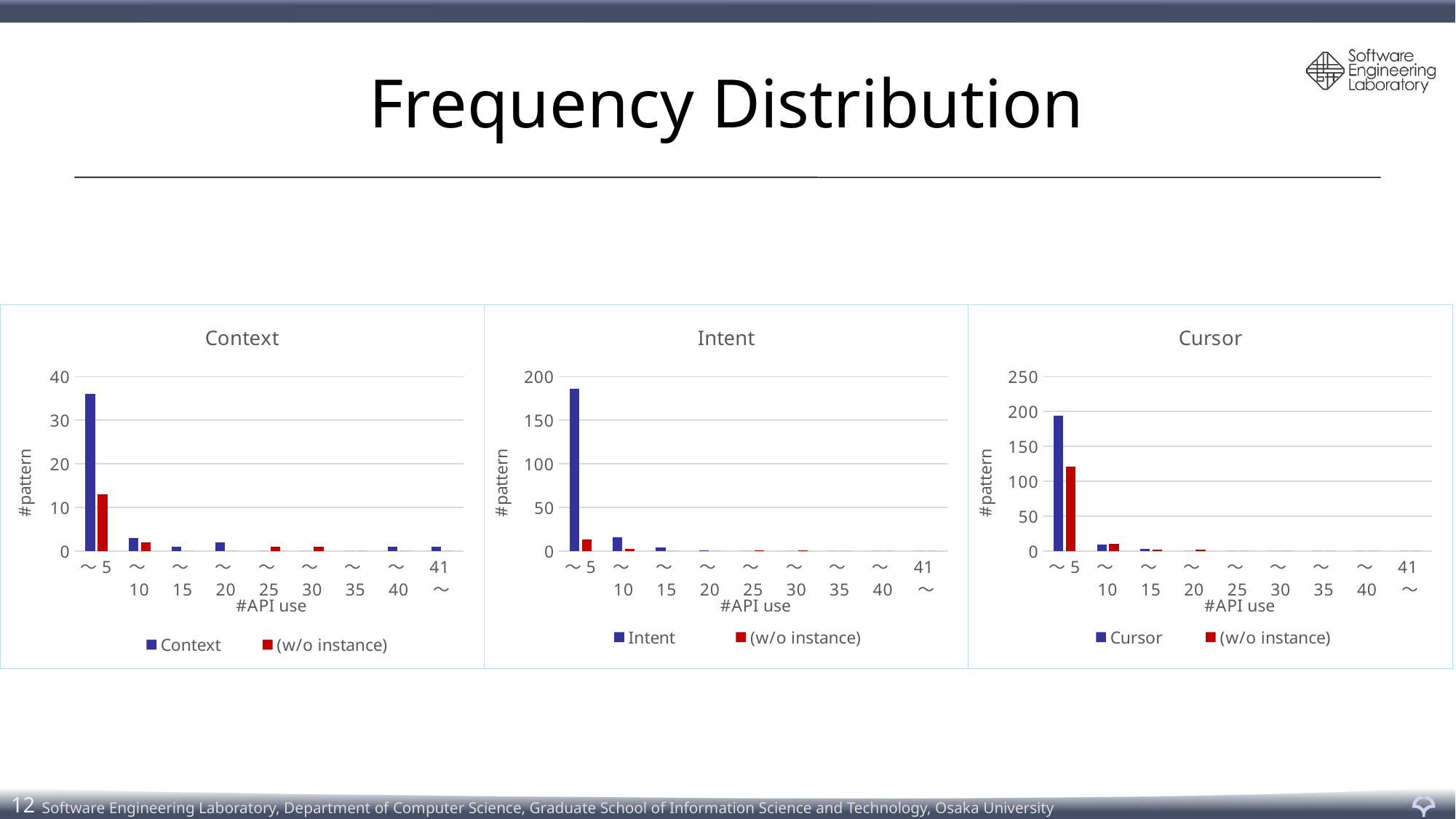
How many categories are shown on the x axis of the Cursor chart? 9 In the Cursor chart, is the (w/o instance) value for the ～5 category greater or less than 150? less In the Cursor chart, for the ～5 category, which series has the larger value: Cursor or (w/o instance)? Cursor What is the label of the y axis on the Intent chart? #pattern In the Context chart, is the (w/o instance) value for the ～5 category greater or less than 10? greater In the Intent chart, which #API use category has the highest number of patterns for the Intent series? ～5 In the Context chart, is the Context value for the ～5 category greater or less than 30? greater What kind of chart is the Context chart? bar chart How many series does the legend of the Intent chart list? 2 In the Context chart, which #API use category has the highest number of patterns for the Context series? ～5